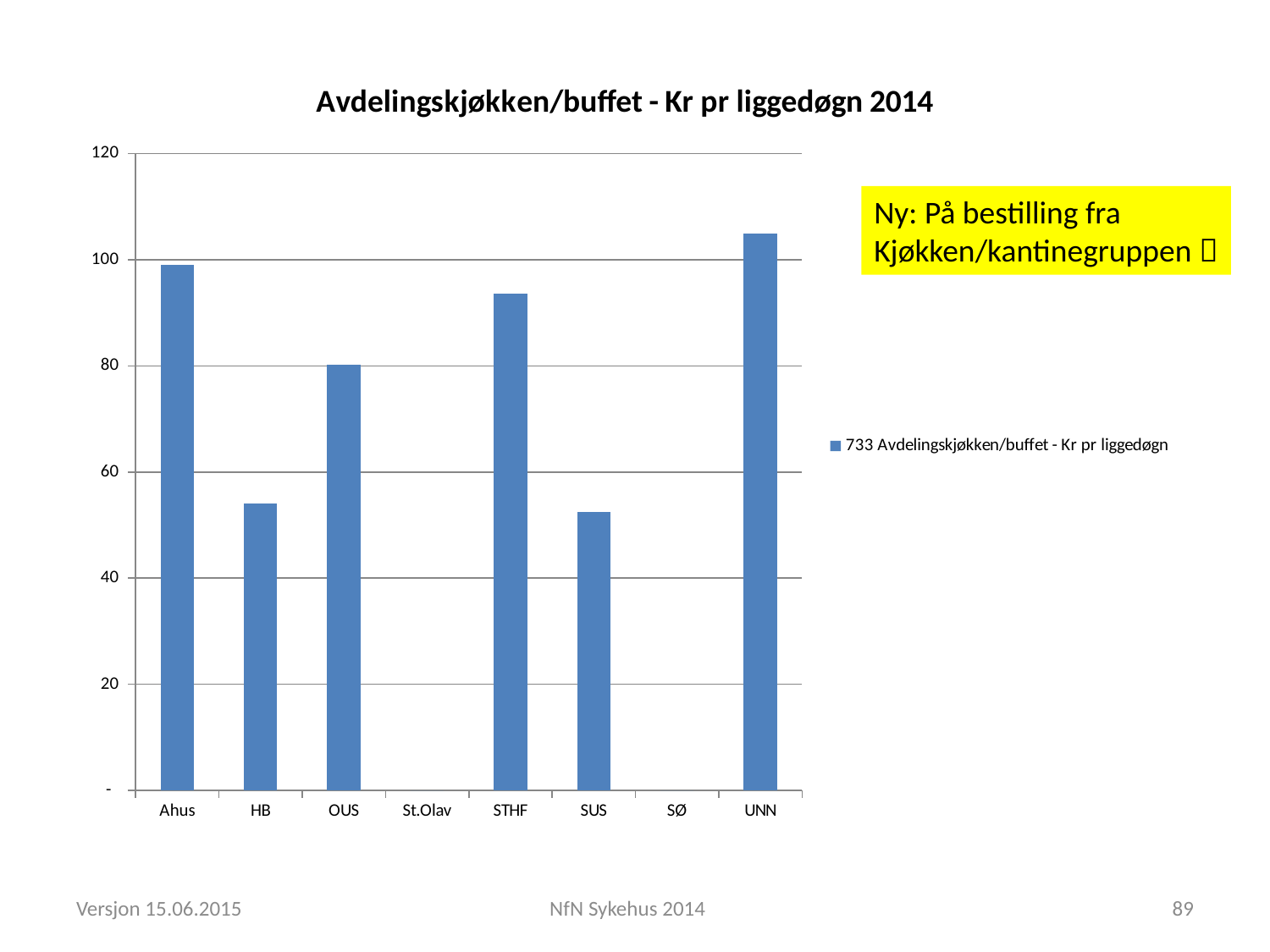
What is the title of the chart? Avdelingskjøkken/buffet - Kr pr liggedøgn 2014 Is the value for STHF greater or less than 80? greater Which category has the highest value in the chart? UNN Is the value for HB greater or less than 60? less How many series does the legend list? 1 What kind of chart is shown on the slide? Bar chart Is the value for SUS greater or less than 60? less Which has the larger value, Ahus or OUS? Ahus What is the legend entry for the series in the chart? 733 Avdelingskjøkken/buffet - Kr pr liggedøgn Which has the larger value, STHF or HB? STHF How many categories are shown on the x axis of the chart? 8